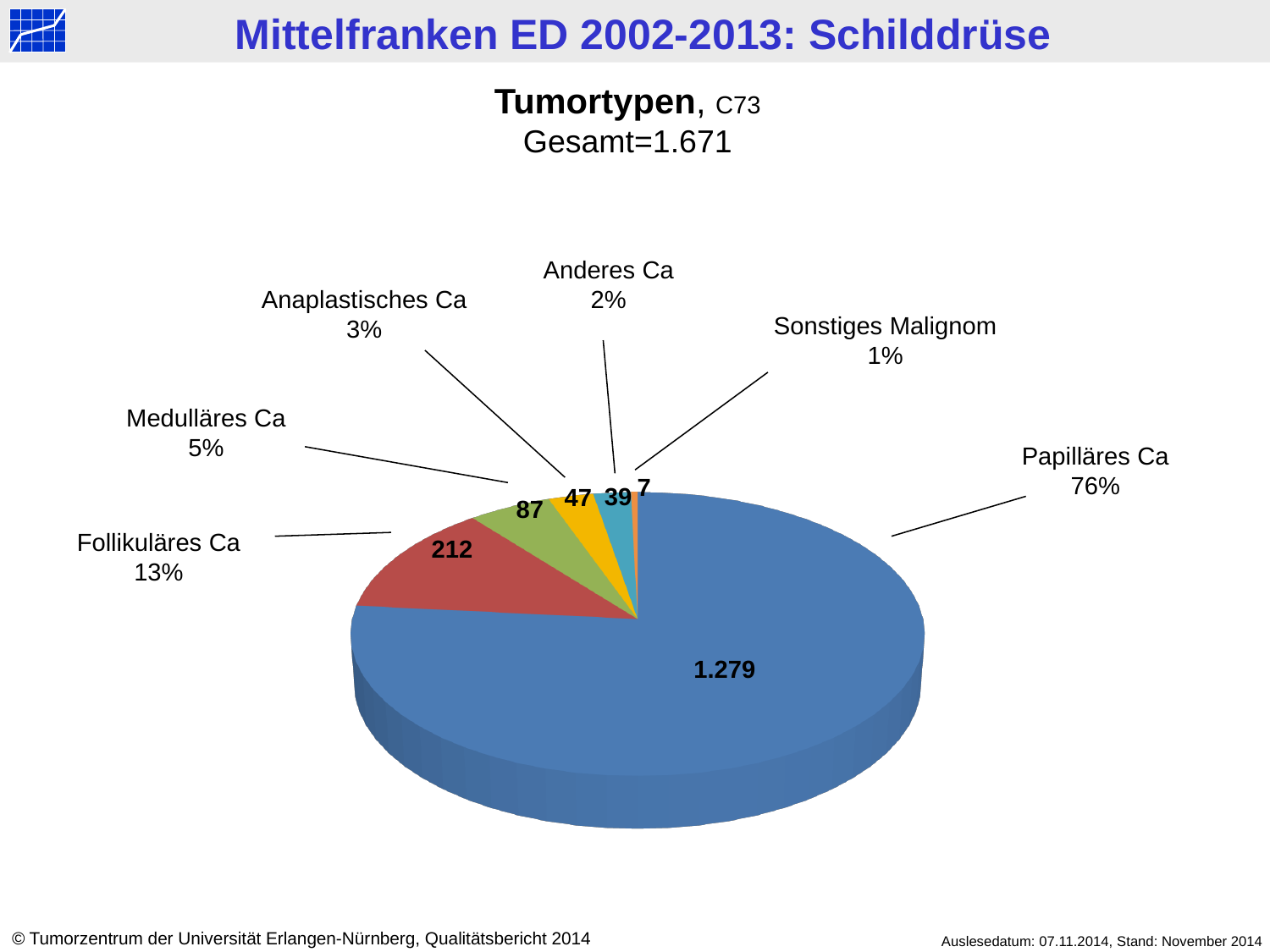
What is the difference between the values for Follikuläres Ca and Medulläres Ca? 125 What is the value for Papilläres Ca? 1.279 What share of the pie does Follikuläres Ca represent? 13% Which tumour type has the smallest slice? Sonstiges Malignom What kind of chart is shown on the slide? pie chart What share of the pie does Anderes Ca represent? 2% What is the value for Anaplastisches Ca? 47 What is the value for Medulläres Ca? 87 What is the value for Follikuläres Ca? 212 What total (Gesamt) is stated above the chart? 1.671 Which tumour type has the largest slice? Papilläres Ca How many slices does the pie chart have? 6